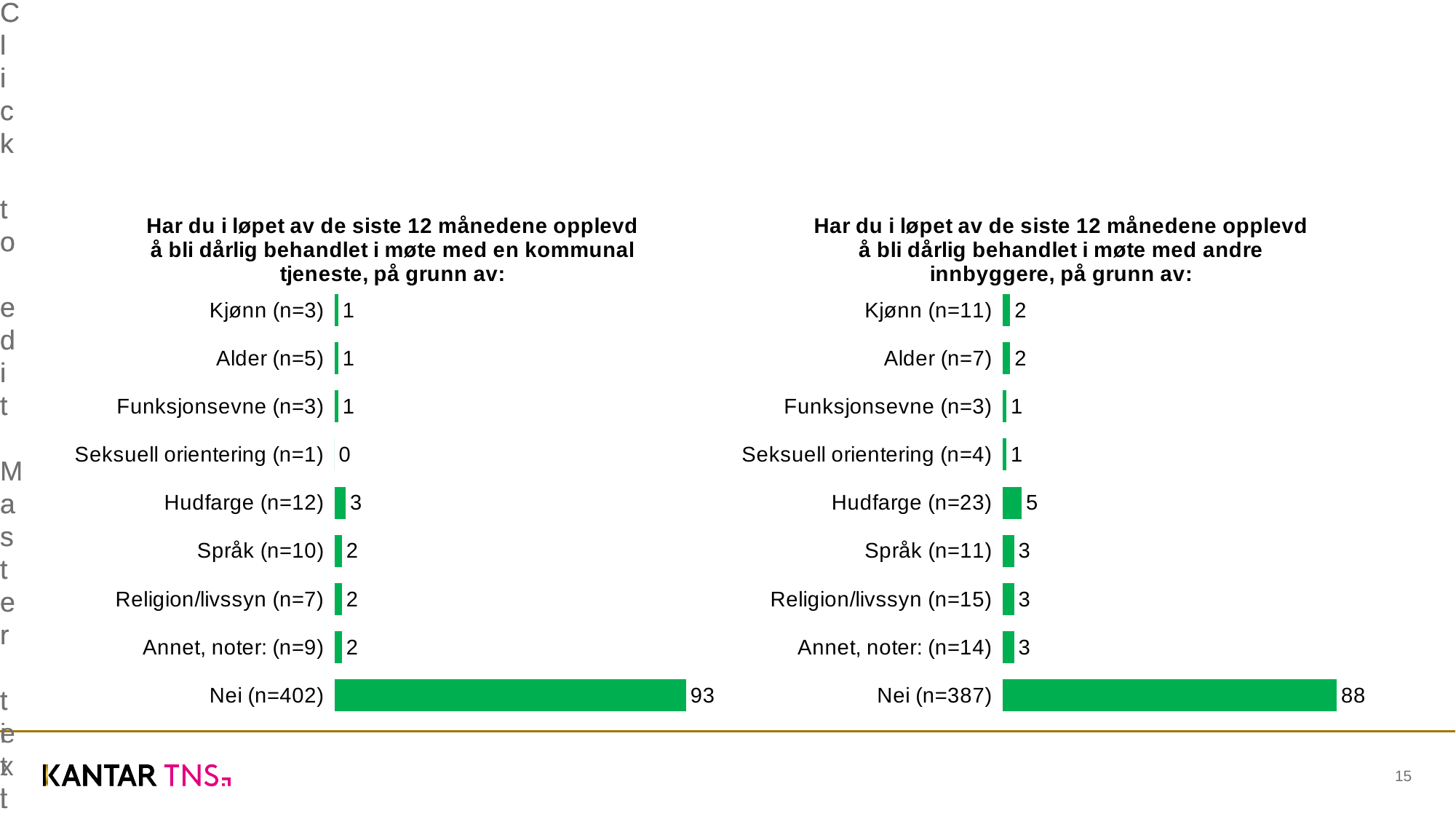
What type of chart is used on this slide? Bar chart How many categories are shown in the left chart (kommunal tjeneste)? 9 Which is larger: the value for Nei in the left chart or the value for Nei in the right chart? Nei in the left chart (93) In the left chart (kommunal tjeneste), which category has the lowest value? Seksuell orientering (n=1) What colour are the bars in both charts? Green In the right chart (andre innbyggere), which is larger: Hudfarge (n=23) or Språk (n=11)? Hudfarge (n=23) In the left chart (kommunal tjeneste), what is the value for Seksuell orientering (n=1)? 0 In the left chart (kommunal tjeneste), what is the value for Hudfarge (n=12)? 3 In the right chart (andre innbyggere), what is the difference between Nei (n=387) and Hudfarge (n=23)? 83 In the right chart (andre innbyggere), what is the value for Kjønn (n=11)? 2 In the left chart (kommunal tjeneste), which category has the highest value? Nei (n=402) In the right chart (andre innbyggere), what is the value for Nei (n=387)? 88